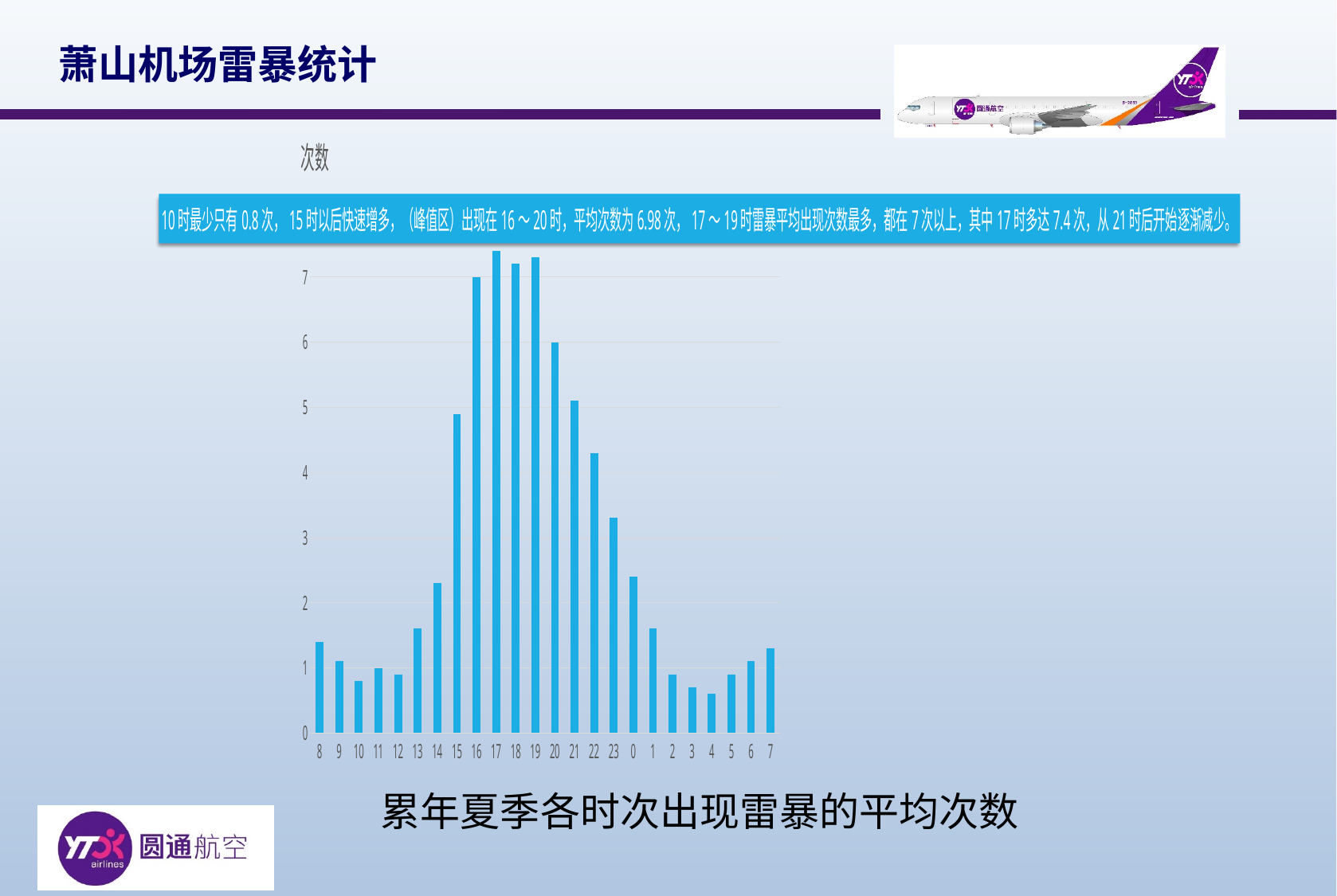
Which is larger, the value for hour 16 or the value for hour 20? hour 16 What kind of chart is shown on the slide? bar chart Which is larger, the value for hour 22 or the value for hour 23? hour 22 What is the label on the vertical axis of the chart? 次数 How many hour categories are plotted along the x axis? 24 Is the value for hour 0 greater or less than 2? greater According to the slide, what is the average number of thunderstorms at hour 17? 7.4次 Is the value for hour 13 greater or less than 1? greater Is the value for hour 16 greater or less than 6? greater Which hour has the highest average number of thunderstorms? 17 Do the values rise or fall from hour 17 to hour 23? fall